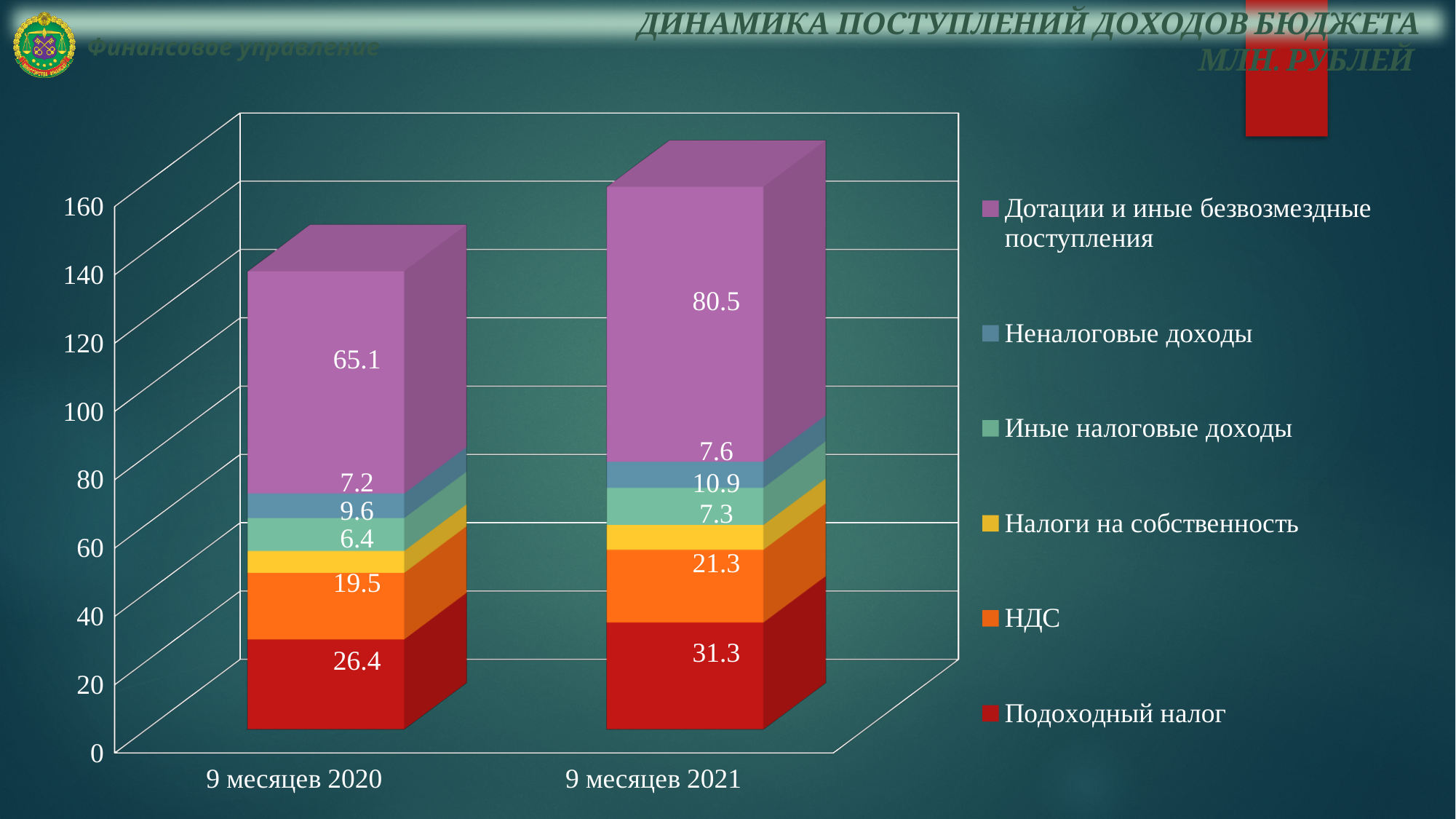
What is the title of the chart? ДИНАМИКА ПОСТУПЛЕНИЙ ДОХОДОВ БЮДЖЕТА МЛН. РУБЛЕЙ What is the value of Дотации и иные безвозмездные поступления for 9 месяцев 2020? 65.1 By how much did Дотации и иные безвозмездные поступления increase from 9 месяцев 2020 to 9 месяцев 2021? 15.4 What is the value of Подоходный налог for 9 месяцев 2020? 26.4 What is the value of Подоходный налог for 9 месяцев 2021? 31.3 What kind of chart is shown on the slide? Stacked bar chart What is the value of НДС for 9 месяцев 2021? 21.3 Which series is the largest segment in the 9 месяцев 2021 bar? Дотации и иные безвозмездные поступления How many categories are shown on the x axis? 2 What is the value of Дотации и иные безвозмездные поступления for 9 месяцев 2021? 80.5 Which period has the larger value for НДС, 9 месяцев 2020 or 9 месяцев 2021? 9 месяцев 2021 How many series does the legend list? 6